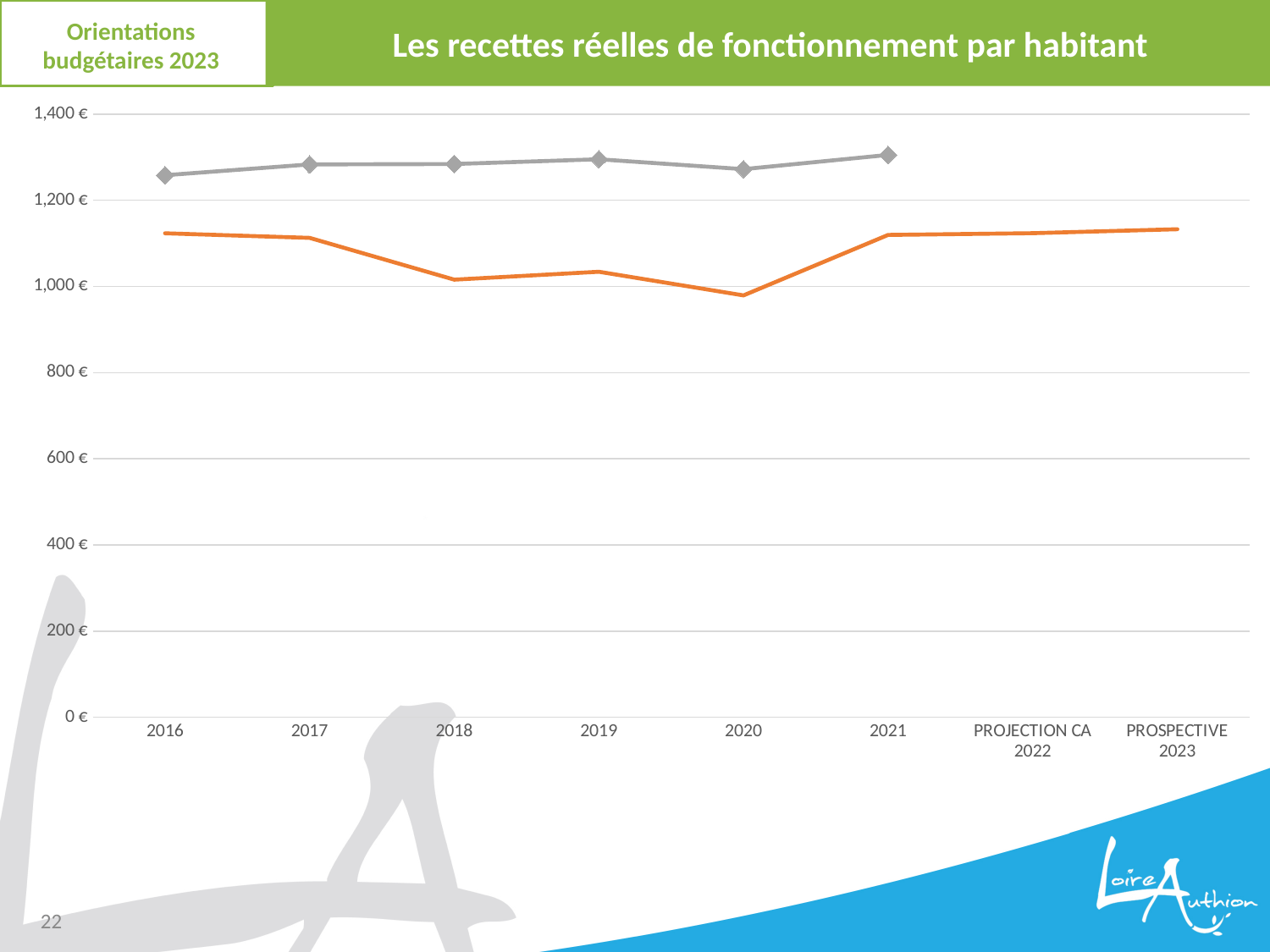
Is the value of the grey line in 2021 greater or less than 1,400 €? less In 2018, which line has the higher value, the grey line or the orange line? the grey line What kind of chart is shown on the slide? line chart What is the title of the chart? Les recettes réelles de fonctionnement par habitant In which year does the orange line reach its lowest value? 2020 Is the value of the orange line in 2020 greater or less than 1,000 €? less How many categories are shown on the x axis? 8 Does the orange line rise or fall between 2020 and 2021? rise Is the value of the orange line in 2021 greater or less than 1,200 €? less How many data points does the grey line with diamond markers have? 6 How many lines are plotted on the chart? 2